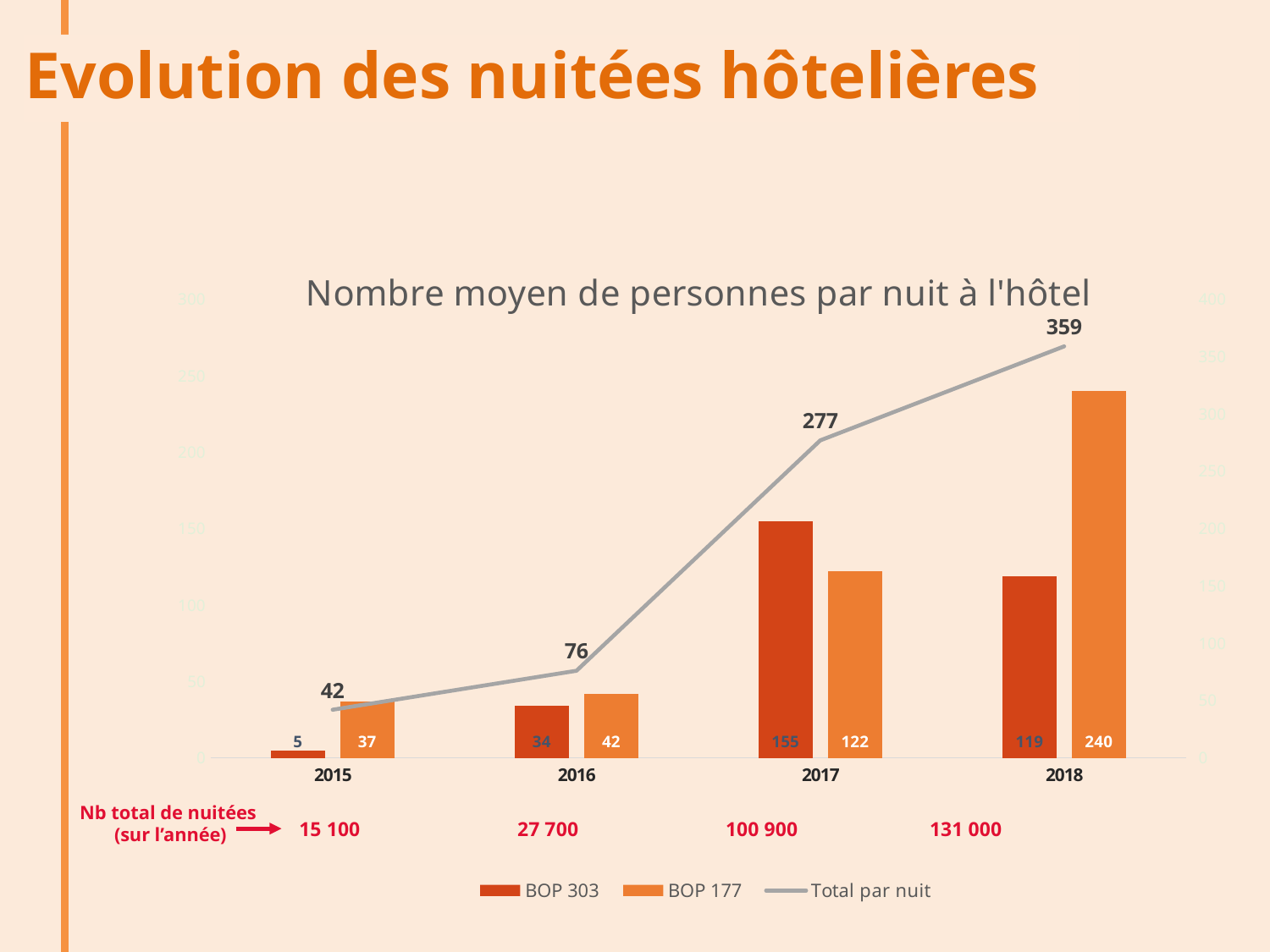
What is the value for BOP 303 in 2015? 5 What is the value for BOP 303 in 2017? 155 What is the title of the chart? Nombre moyen de personnes par nuit à l'hôtel How many years are shown on the x axis? 4 What is the value for BOP 177 in 2018? 240 In which year is the BOP 177 value lowest? 2015 What is the difference between BOP 177 and BOP 303 in 2018? 121 Does the Total par nuit line rise or fall from 2015 to 2018? rises What is the value of Total par nuit in 2016? 76 How many series does the legend list? 3 In which year is Total par nuit highest? 2018 In 2017, which is larger, BOP 303 or BOP 177? BOP 303